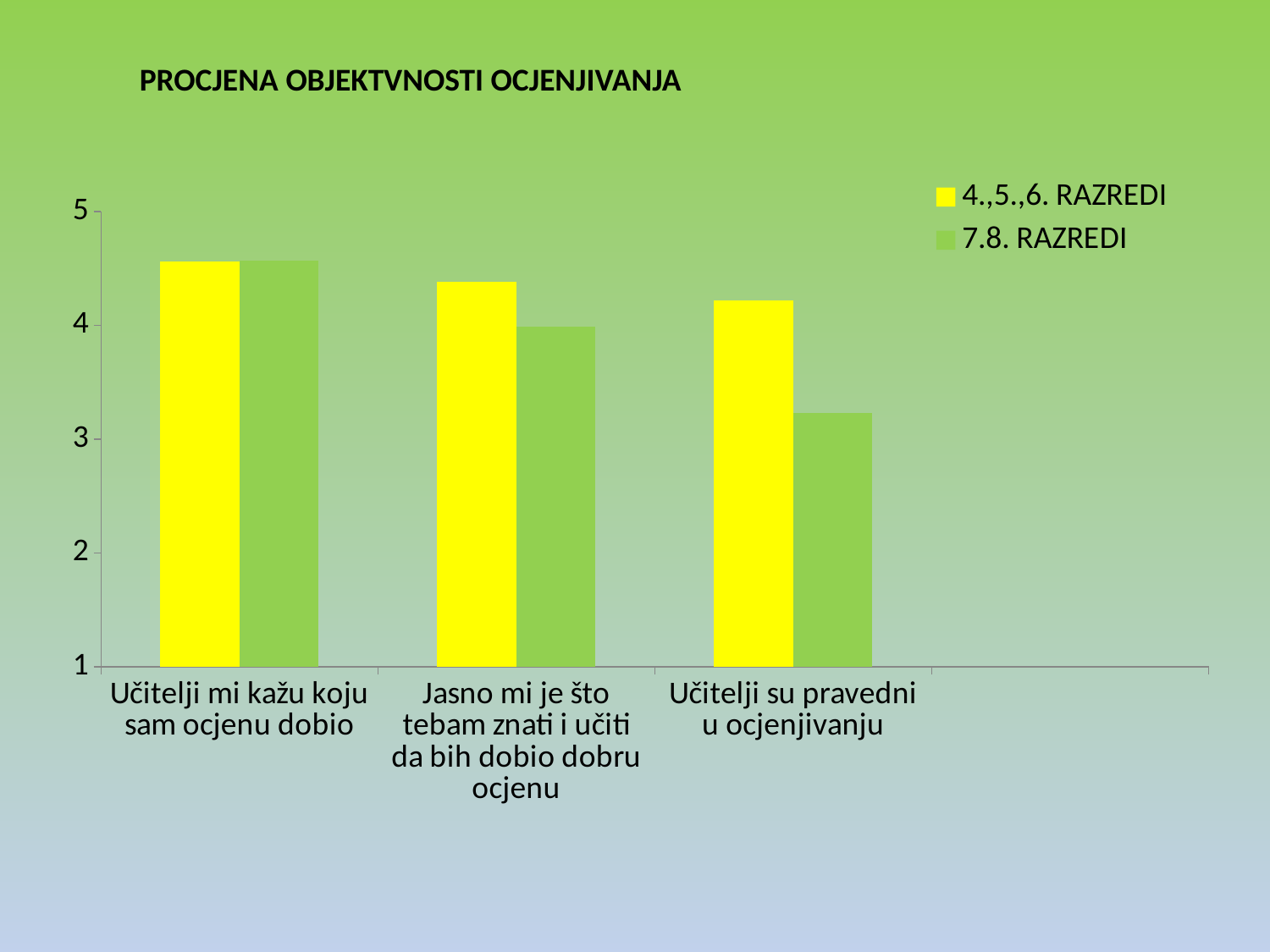
In the category "Učitelji su pravedni u ocjenjivanju", which series has the larger value, 4.,5.,6. RAZREDI or 7.8. RAZREDI? 4.,5.,6. RAZREDI Is the value for 4.,5.,6. RAZREDI in the category "Učitelji su pravedni u ocjenjivanju" greater or less than 4? greater What is the title of the chart? PROCJENA OBJEKTVNOSTI OCJENJIVANJA Do the values for 7.8. RAZREDI rise or fall from left to right along the x axis? fall Is the value for 4.,5.,6. RAZREDI in the category "Učitelji mi kažu koju sam ocjenu dobio" greater or less than 4? greater How many series does the legend list? 2 Which series is shown in yellow? 4.,5.,6. RAZREDI For the series 7.8. RAZREDI, which category has the lowest value? Učitelji su pravedni u ocjenjivanju For the series 7.8. RAZREDI, which category has the highest value? Učitelji mi kažu koju sam ocjenu dobio How many categories are shown on the x axis? 3 Is the value for 7.8. RAZREDI in the category "Učitelji su pravedni u ocjenjivanju" greater or less than 4? less What kind of chart is shown on the slide? bar chart